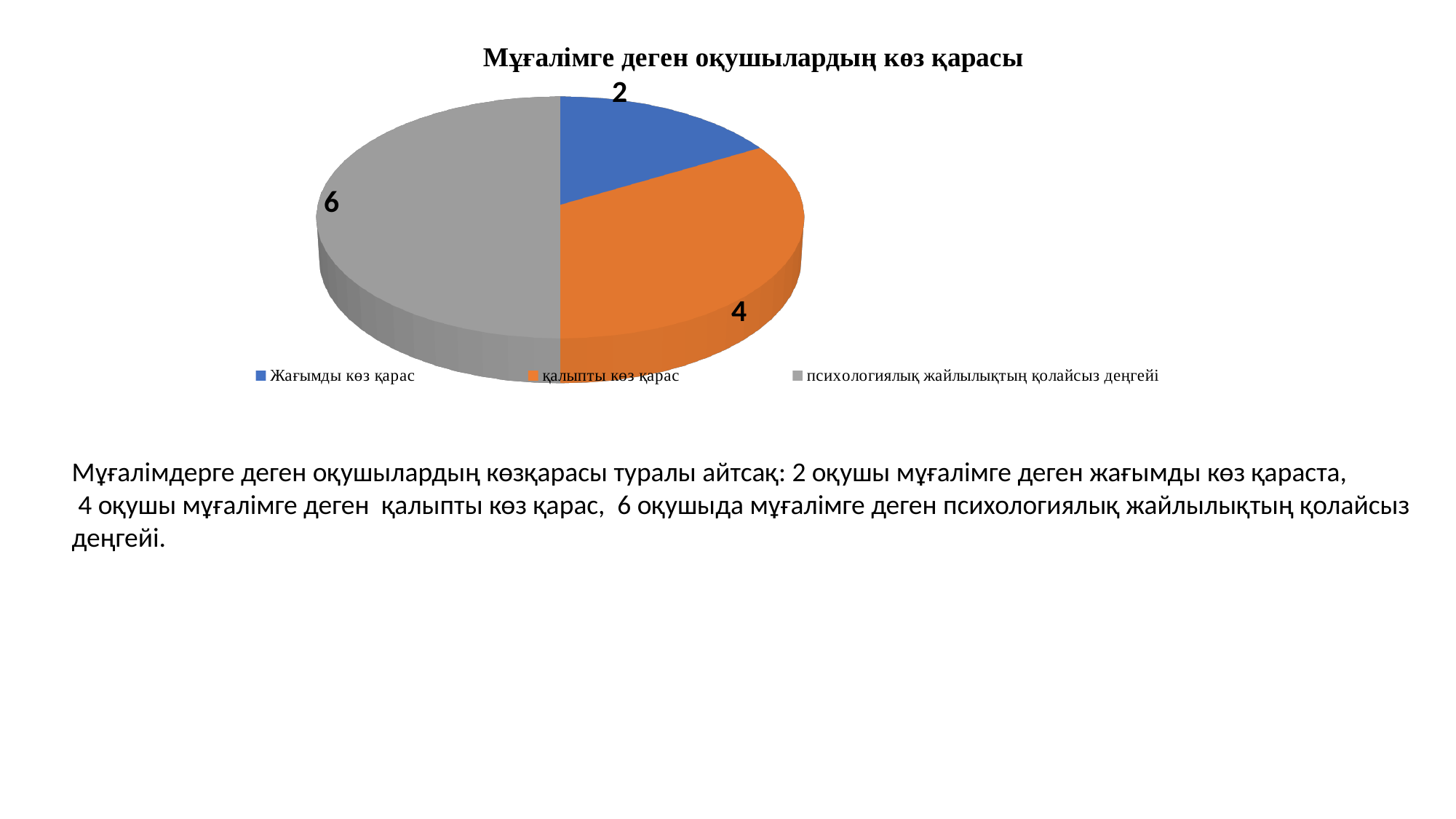
What is the value for "Жағымды көз қарас"? 2 Which category has the smallest slice of the pie? Жағымды көз қарас What is the difference between the values for "психологиялық жайлылықтың қолайсыз деңгейі" and "Жағымды көз қарас"? 4 What is the title of the chart? Мұғалімге деген оқушылардың көз қарасы What is the value for "психологиялық жайлылықтың қолайсыз деңгейі"? 6 What is the value for "қалыпты көз қарас"? 4 What colour is the slice for "қалыпты көз қарас"? Orange What type of chart is shown on the slide? Pie chart How many slices does the pie chart have? 3 What share of the pie does "психологиялық жайлылықтың қолайсыз деңгейі" represent? 50% Which category has the largest slice of the pie? психологиялық жайлылықтың қолайсыз деңгейі Which is larger, the value for "қалыпты көз қарас" or the value for "Жағымды көз қарас"? қалыпты көз қарас